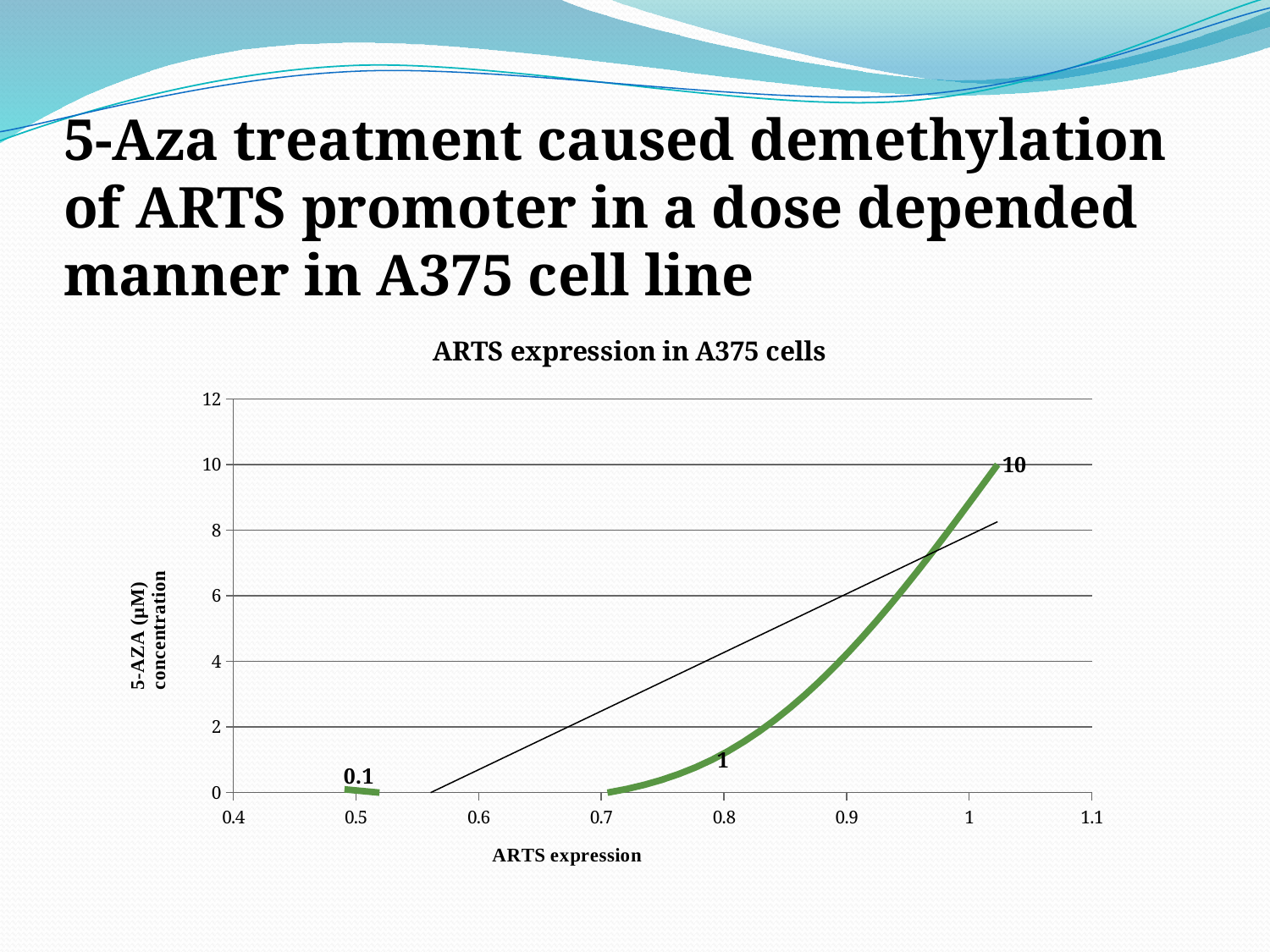
What is the title of the chart? ARTS expression in A375 cells What is the highest data label shown on the chart? 10 What is the label of the vertical axis of the chart? 5-AZA (µM) concentration What is the lowest data label shown on the chart? 0.1 Does the 5-AZA concentration rise or fall as ARTS expression increases along the x axis? rise What kind of chart is shown on the slide? line chart Which labeled point has the larger 5-AZA concentration, the one at ARTS expression near 0.8 or the one near 1.0? the one near 1.0 Is the 5-AZA concentration of the point at ARTS expression near 0.8 greater or less than 2? less What is the difference between the point labeled 1 and the point labeled 0.1? 0.9 Is the 5-AZA concentration of the rightmost data point greater or less than 8? greater How many labeled data points are plotted on the chart? 3 What is the difference between the highest labeled point (10) and the middle labeled point (1)? 9